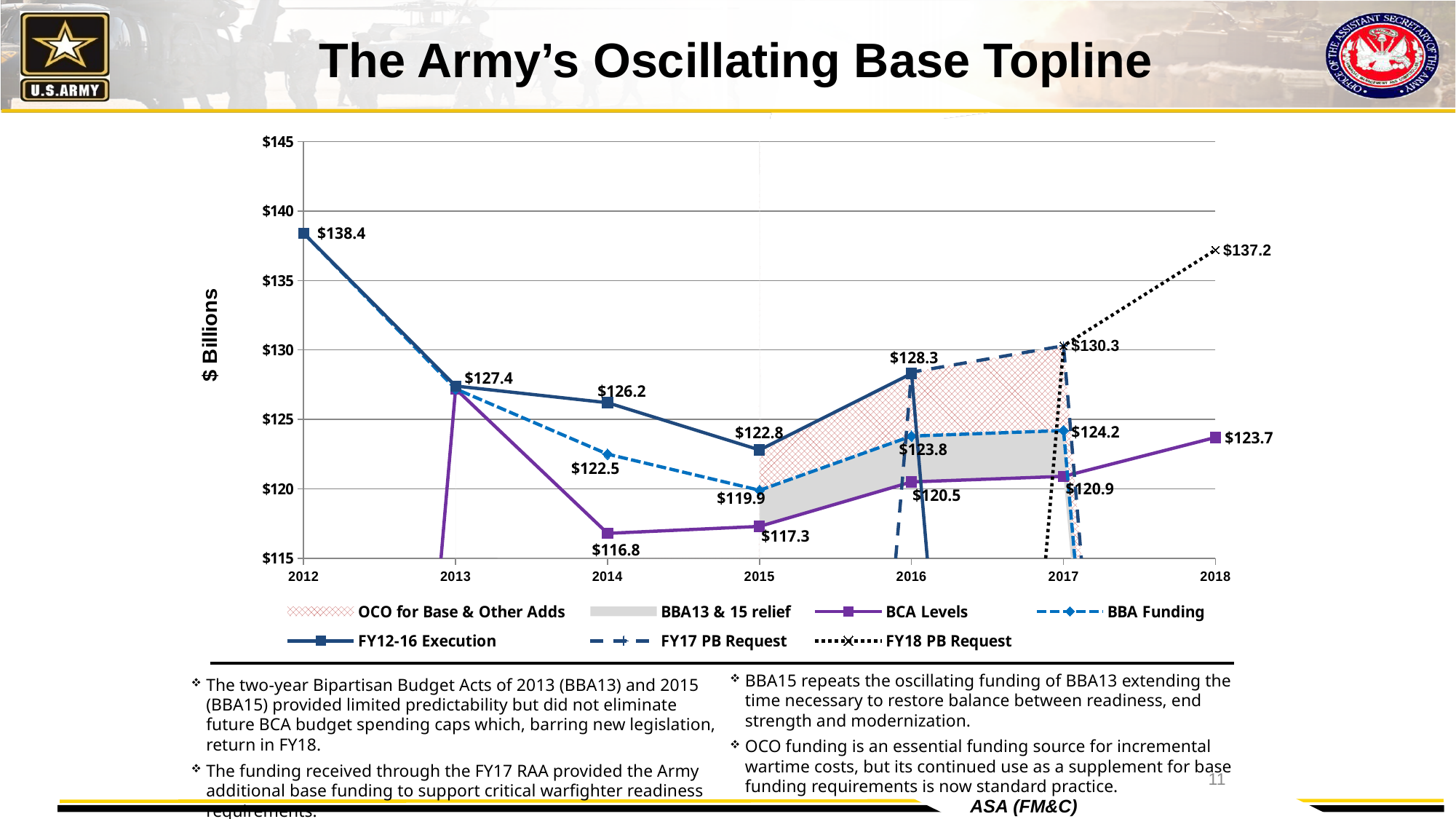
What is the FY18 PB Request value for 2018? $137.2 What is the FY12-16 Execution value for 2016? $128.3 What is the FY12-16 Execution value for 2012? $138.4 What is the difference between the FY12-16 Execution values for 2012 and 2013? $11.0 What is the BCA Levels value for 2014? $116.8 Does the FY12-16 Execution line rise or fall from 2012 to 2015? fall What kind of chart is shown on the slide? line chart In which year is the FY12-16 Execution line at its highest? 2012 What is the label on the vertical axis of the chart? $ Billions Which is larger, the FY12-16 Execution value for 2015 or for 2016? 2016 In which year is the BCA Levels line at its lowest? 2014 How many series does the chart legend list? 7